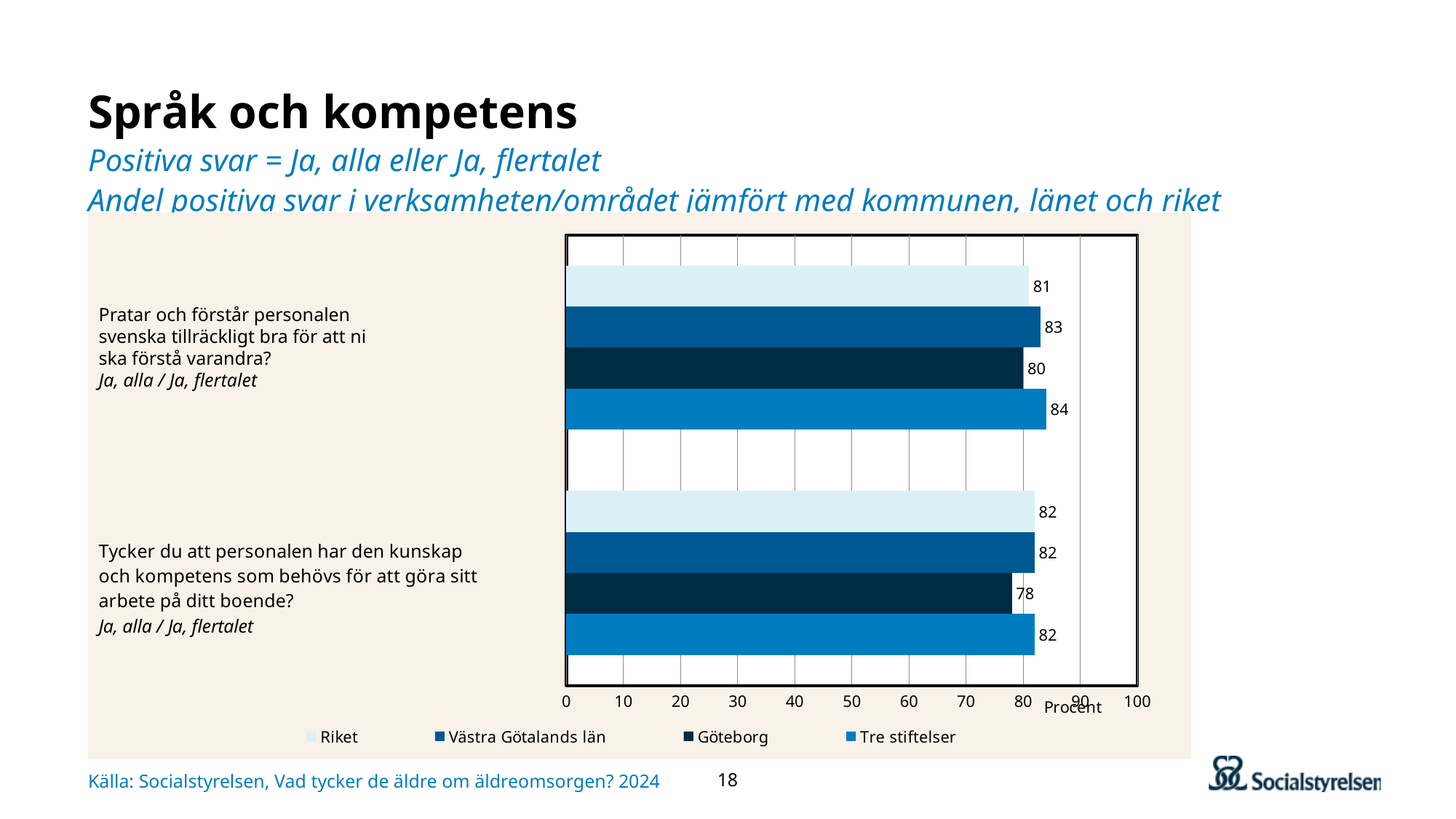
What is the value for Göteborg on the question "Tycker du att personalen har den kunskap och kompetens som behövs för att göra sitt arbete på ditt boende?"? 78 What is the value for Riket on the question "Pratar och förstår personalen svenska tillräckligt bra för att ni ska förstå varandra?"? 81 What is the difference between Tre stiftelser and Göteborg on the question "Pratar och förstår personalen svenska tillräckligt bra för att ni ska förstå varandra?"? 4 Which series has the highest value on the question "Pratar och förstår personalen svenska tillräckligt bra för att ni ska förstå varandra?"? Tre stiftelser How many series does the legend list? 4 What is the difference between Riket and Göteborg on the question "Tycker du att personalen har den kunskap och kompetens som behövs för att göra sitt arbete på ditt boende?"? 4 What unit is shown on the horizontal axis of the chart? Procent What is the value for Tre stiftelser on the question "Pratar och förstår personalen svenska tillräckligt bra för att ni ska förstå varandra?"? 84 Which series has the lowest value on the question "Tycker du att personalen har den kunskap och kompetens som behövs för att göra sitt arbete på ditt boende?"? Göteborg What is the value for Västra Götalands län on the question "Tycker du att personalen har den kunskap och kompetens som behövs för att göra sitt arbete på ditt boende?"? 82 Which is larger on the question "Pratar och förstår personalen svenska tillräckligt bra för att ni ska förstå varandra?": Västra Götalands län or Göteborg? Västra Götalands län What kind of chart is shown on the slide? Bar chart